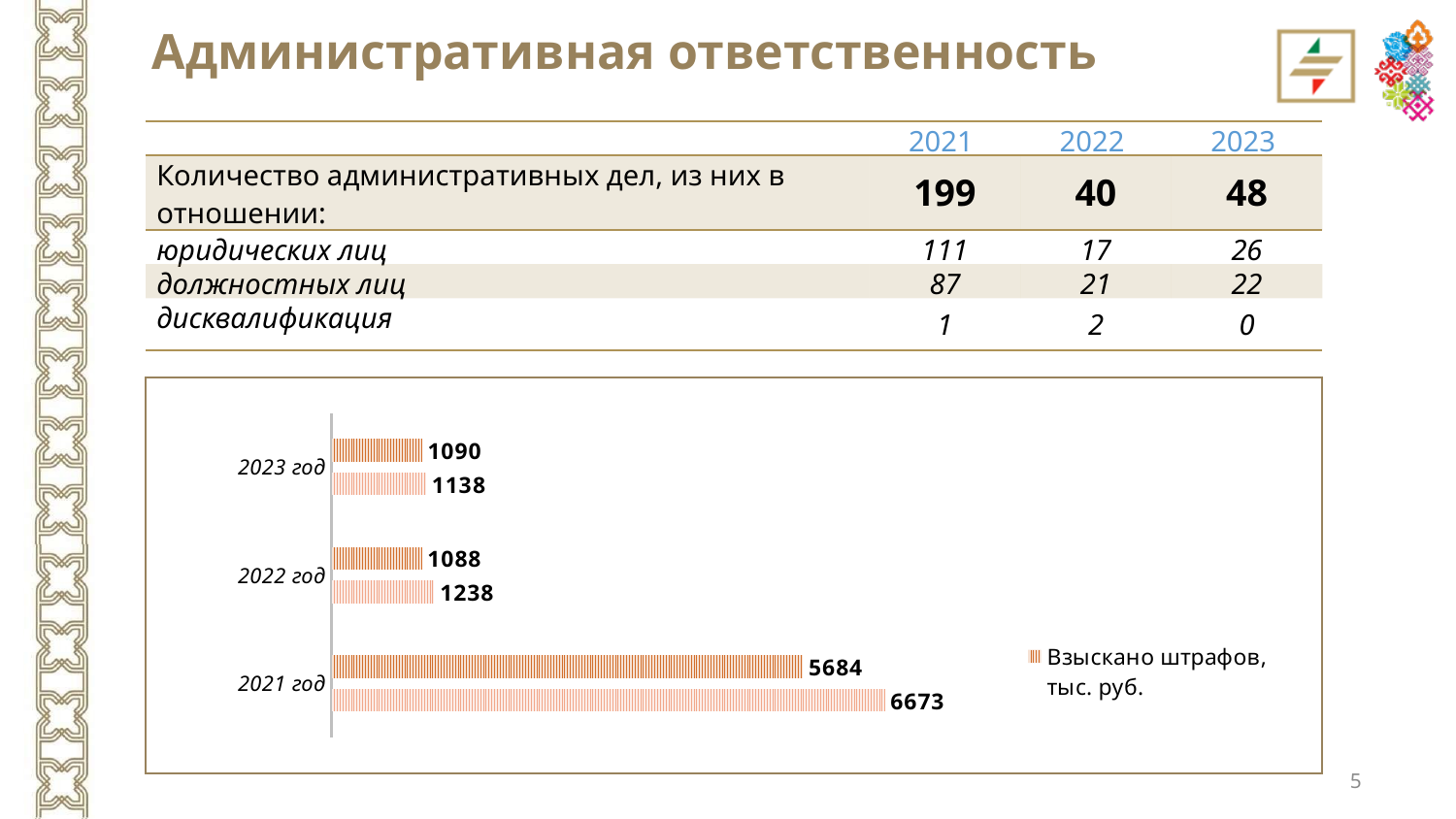
What is the value of the lower bar for 2022 год? 1238 What is the legend entry shown on the bar chart? Взыскано штрафов, тыс. руб. What is the value of the upper bar for 2021 год? 5684 What kind of chart is shown on the slide? bar chart How many year categories are shown on the bar chart? 3 Which is larger: the lower bar for 2022 год or the lower bar for 2023 год? 2022 год What is the value of the lower bar for 2021 год? 6673 Which year has the highest value on the bar chart? 2021 год What is the value of the upper bar for 2023 год? 1090 How many series does the chart's legend list? 1 What is the difference between the lower bar (1238) and the upper bar (1088) for 2022 год? 150 What is the difference between the lower bar (6673) and the upper bar (5684) for 2021 год? 989